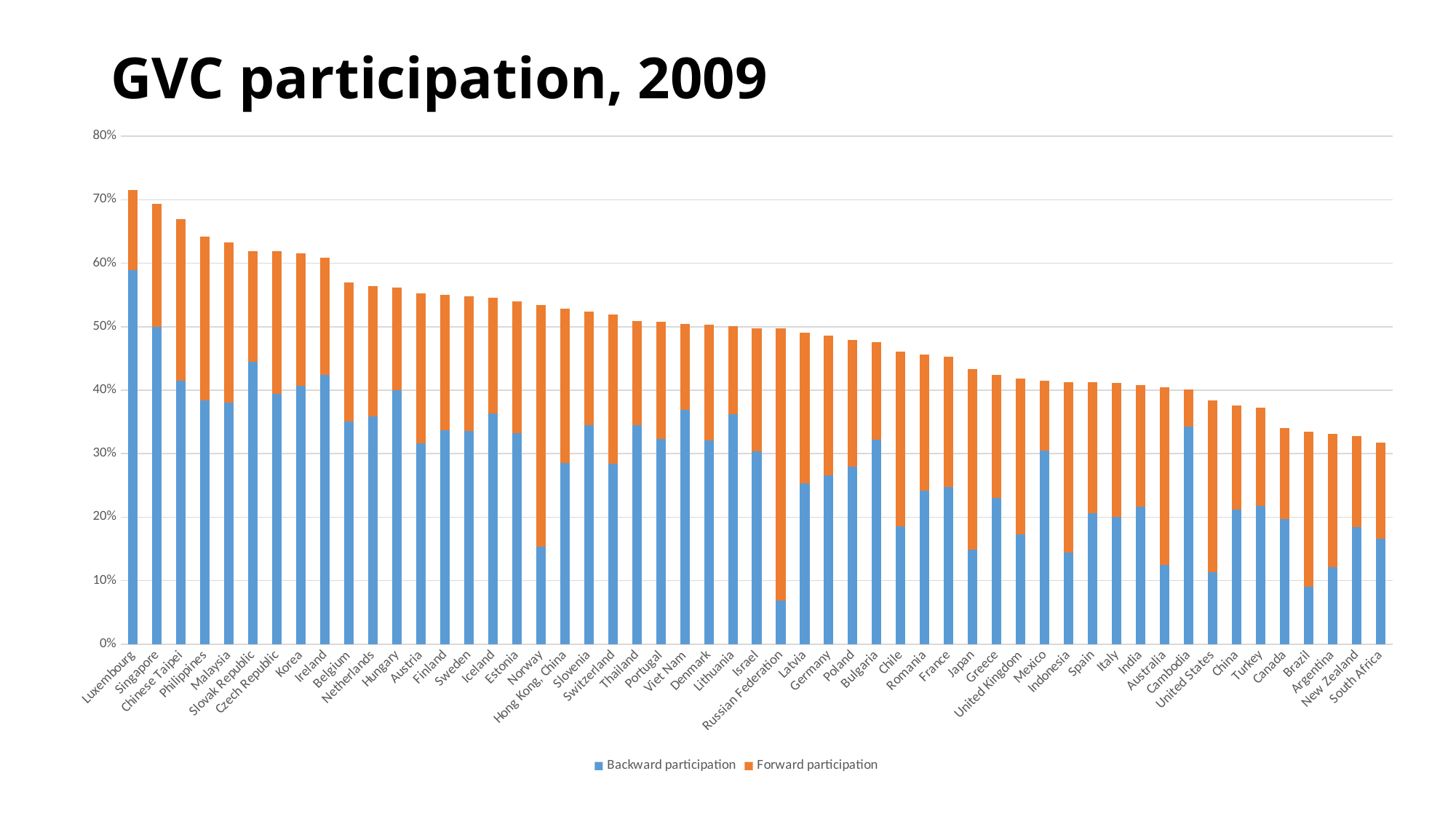
Which country has the highest total GVC participation? Luxembourg Which country has the lowest total GVC participation? South Africa Is the backward participation for Norway greater or less than 20%? less Is the backward participation for Russian Federation greater or less than 10%? less How many countries are shown on the x axis? 53 Do the total GVC participation values rise or fall moving from left to right along the x axis? Fall How many series does the legend list? 2 Which country has the lowest backward participation? Russian Federation What are the two series named in the legend? Backward participation and Forward participation Is the total GVC participation for Luxembourg greater or less than 70%? greater What kind of chart is shown on the slide? Stacked bar chart Which has the larger backward participation, Singapore or Chinese Taipei? Singapore